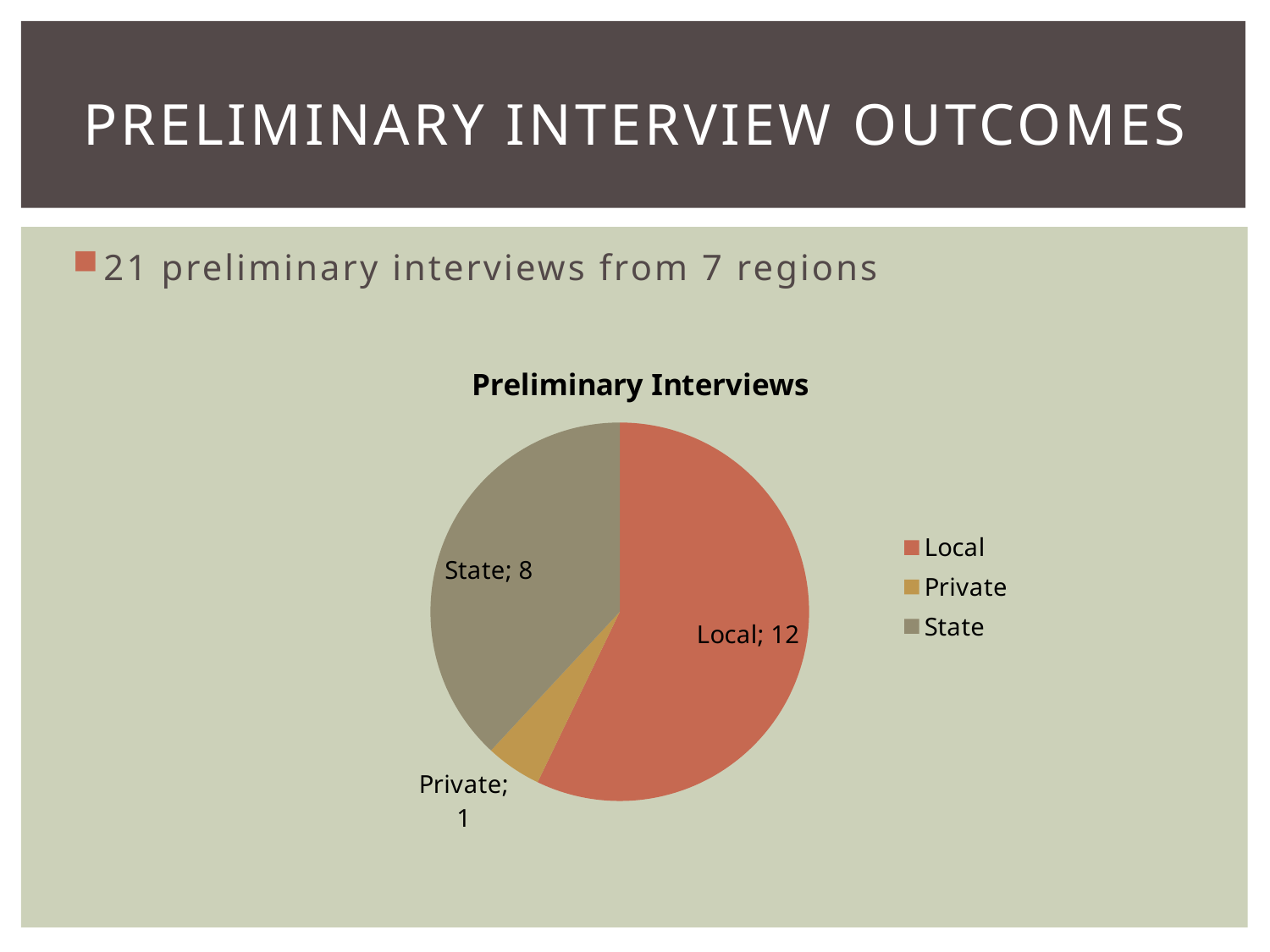
What kind of chart is shown on the slide? Pie chart What is the difference between the Local and State values? 4 Which category has the smallest slice of the pie chart? Private What is the value for Local in the pie chart? 12 Which category is shown in red in the pie chart? Local Which is larger, the value for State or the value for Private? State Which category has the largest slice of the pie chart? Local What is the total of all slices in the pie chart? 21 How many categories are shown in the pie chart? 3 What is the value for State in the pie chart? 8 What is the title of the chart? Preliminary Interviews What is the value for Private in the pie chart? 1